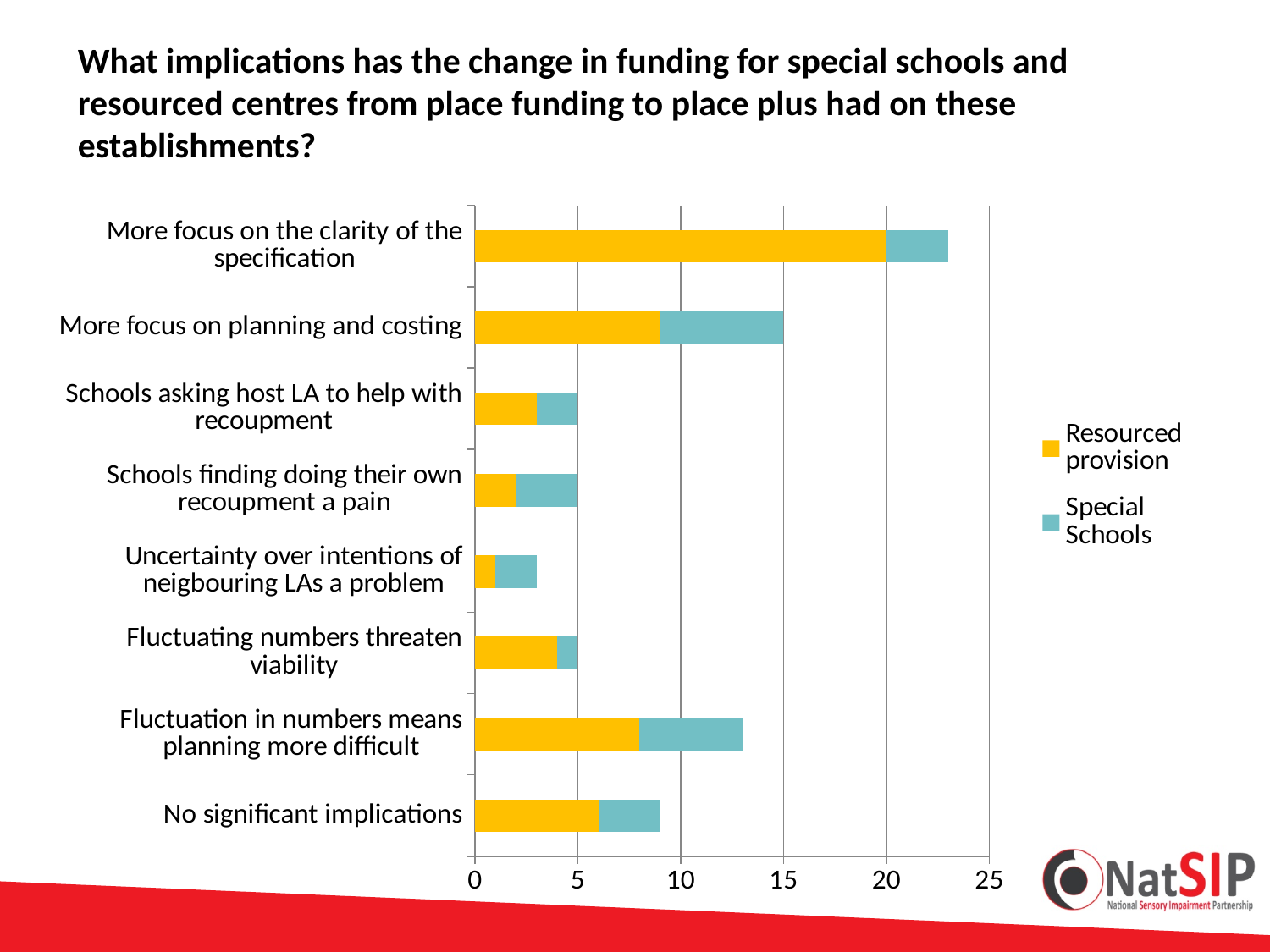
Which has the larger total bar: 'Fluctuation in numbers means planning more difficult' or 'No significant implications'? Fluctuation in numbers means planning more difficult Is the total value for 'No significant implications' greater or less than 10? less What is the total of the stacked bar for 'More focus on planning and costing'? 15 How many categories are plotted on the chart? 8 Which category has the shortest total bar? Uncertainty over intentions of neigbouring LAs a problem What kind of chart is shown on the slide? Stacked bar chart Is the total value for 'More focus on the clarity of the specification' greater or less than 20? greater What is the Resourced provision value for 'More focus on the clarity of the specification'? 20 Which colour represents the Special Schools series in the legend? Teal blue How many series does the legend list? 2 Is the total value for 'Fluctuation in numbers means planning more difficult' greater or less than 10? greater Which category has the longest total bar? More focus on the clarity of the specification